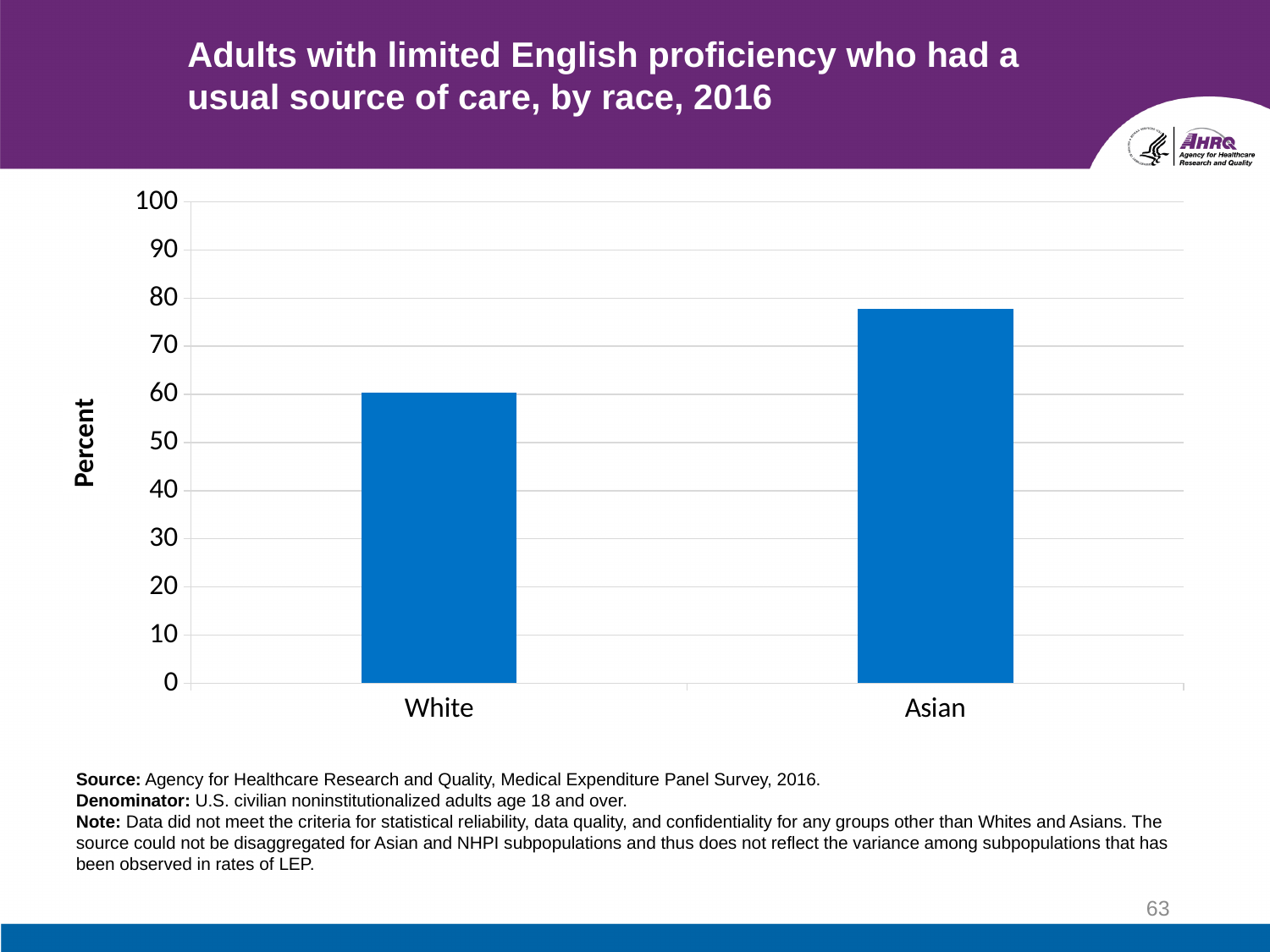
Is the value for White greater or less than 50? greater What kind of chart is shown on the slide? bar chart Is the value for Asian greater or less than 70? greater Is the value for White greater or less than 70? less Which race category has the highest percentage of adults with limited English proficiency who had a usual source of care? Asian How many race categories are plotted on the chart? 2 What is the maximum value shown on the vertical axis? 100 Which is larger, the value for White or the value for Asian? Asian Which race category has the lowest percentage of adults with limited English proficiency who had a usual source of care? White What is the label on the vertical axis of the chart? Percent